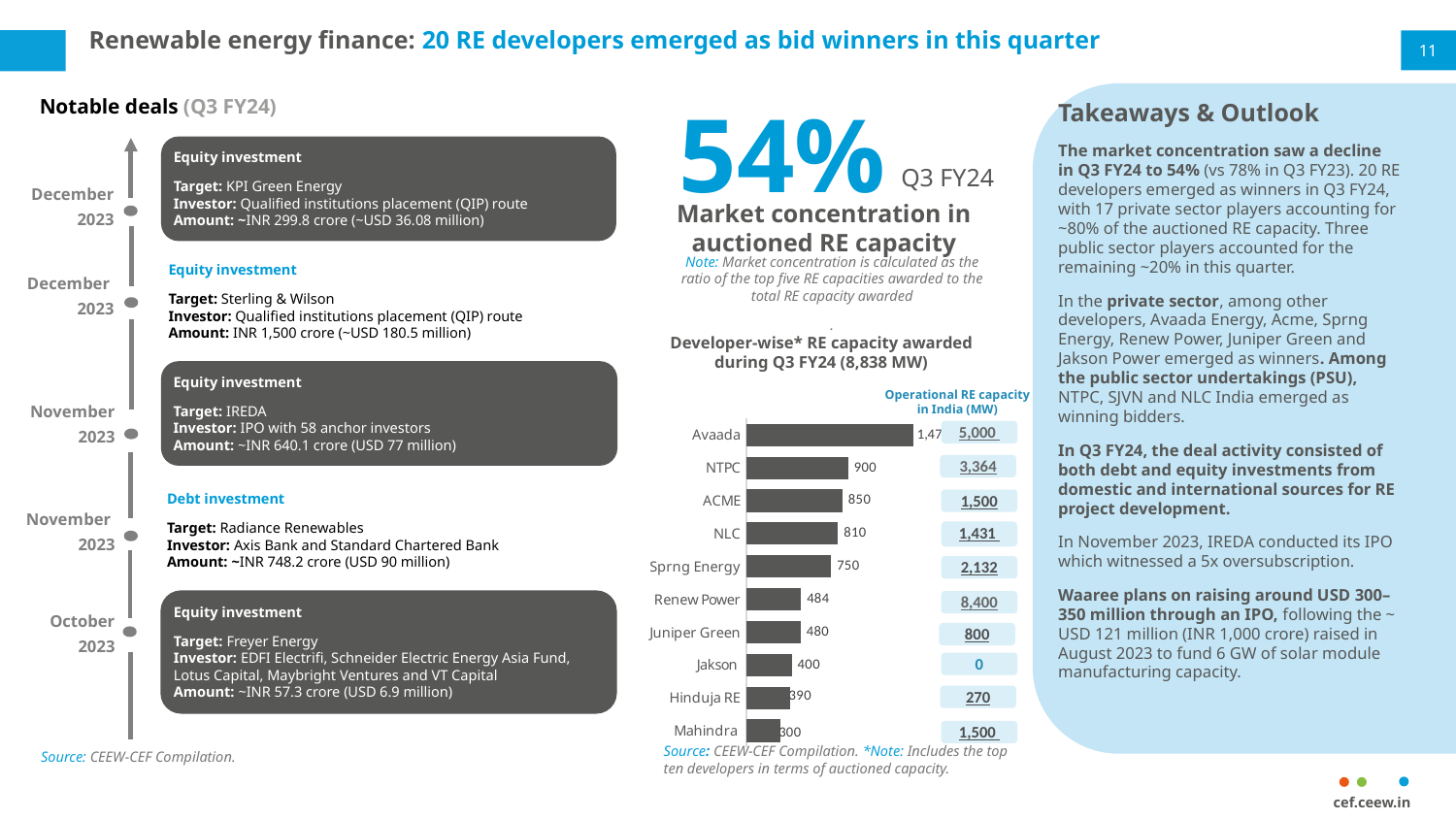
Which developer has the highest RE capacity awarded in the developer-wise chart? Avaada In the developer-wise RE capacity awarded chart, what is the value for Sprng Energy? 750 In the developer-wise RE capacity awarded chart, what is the value for NTPC? 900 In the developer-wise RE capacity awarded chart, what is the value for Hinduja RE? 390 What kind of chart is used to show developer-wise RE capacity awarded during Q3 FY24? Bar chart What total capacity in MW is stated in the title of the developer-wise RE capacity awarded chart? 8,838 MW How many developers are shown in the developer-wise RE capacity awarded chart? 10 In the developer-wise RE capacity awarded chart, which is larger, Renew Power or Juniper Green? Renew Power In the developer-wise RE capacity awarded chart, what is the difference between NTPC and Renew Power? 416 In the developer-wise RE capacity awarded chart, what is the difference between ACME and NLC? 40 Which developer has the lowest RE capacity awarded in the developer-wise chart? Mahindra In the developer-wise RE capacity awarded chart, what is the value for Jakson? 400